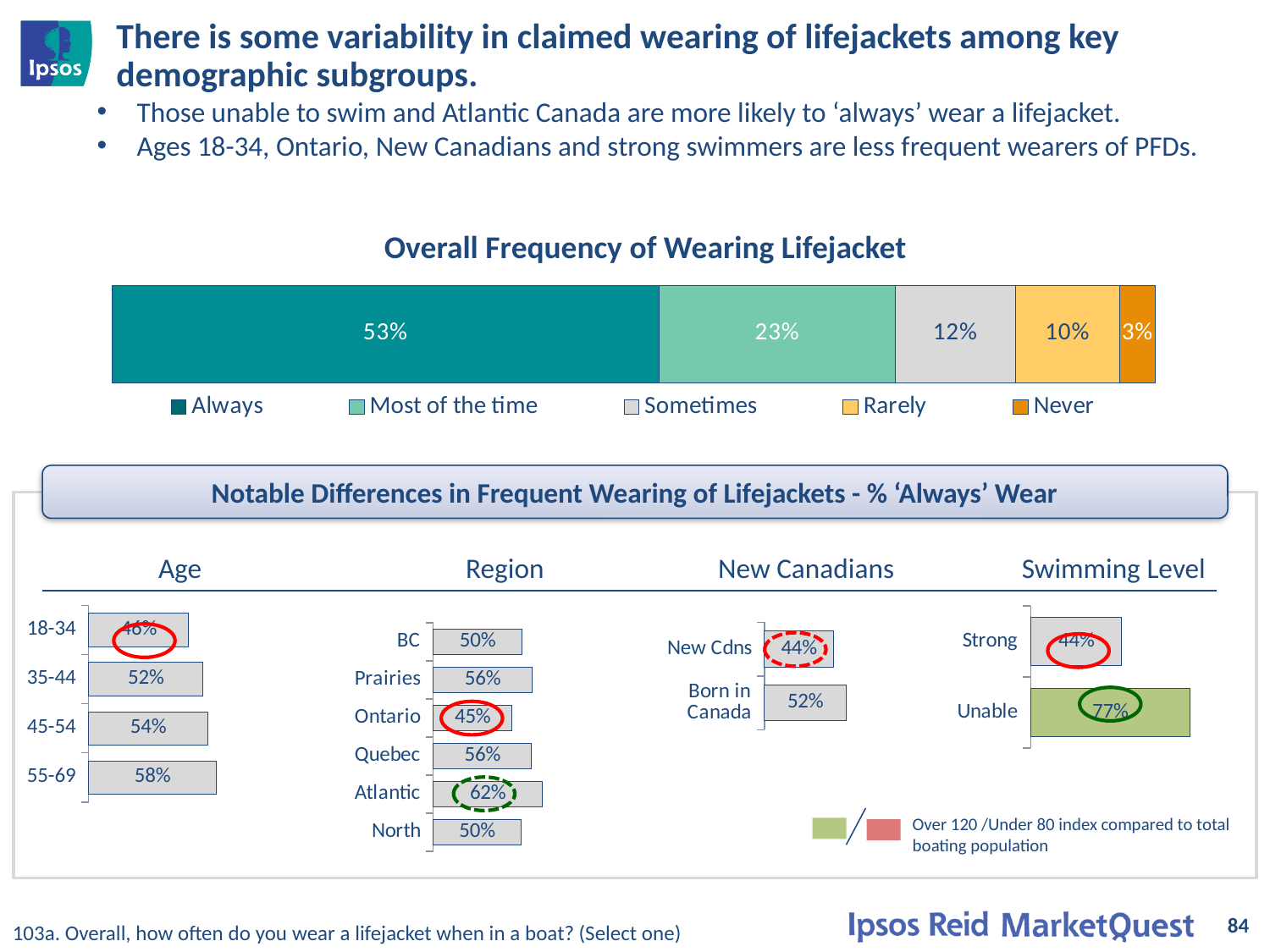
In the Age chart, which age group has the lowest percentage of 'always' wearing a lifejacket? 18-34 How many series does the legend of the Overall Frequency of Wearing Lifejacket chart list? 5 How many regions are shown in the Region chart? 6 In the New Canadians chart, which group has the larger value: New Cdns or Born in Canada? Born in Canada What type of chart is the Overall Frequency of Wearing Lifejacket chart? Stacked bar chart In the Overall Frequency of Wearing Lifejacket chart, what is the difference between the 'Most of the time' and 'Sometimes' percentages? 11% In the Overall Frequency of Wearing Lifejacket chart, what percentage of respondents say they 'Always' wear a lifejacket? 53% In the Region chart, which region has the highest percentage of 'always' wearing a lifejacket? Atlantic In the Overall Frequency of Wearing Lifejacket chart, what percentage say they 'Never' wear a lifejacket? 3% In the Region chart, what is the value for Ontario? 45% In the Swimming Level chart, what is the difference between the 'Unable' and 'Strong' values? 33% In the Age chart, what percentage of those aged 55-69 'always' wear a lifejacket? 58%